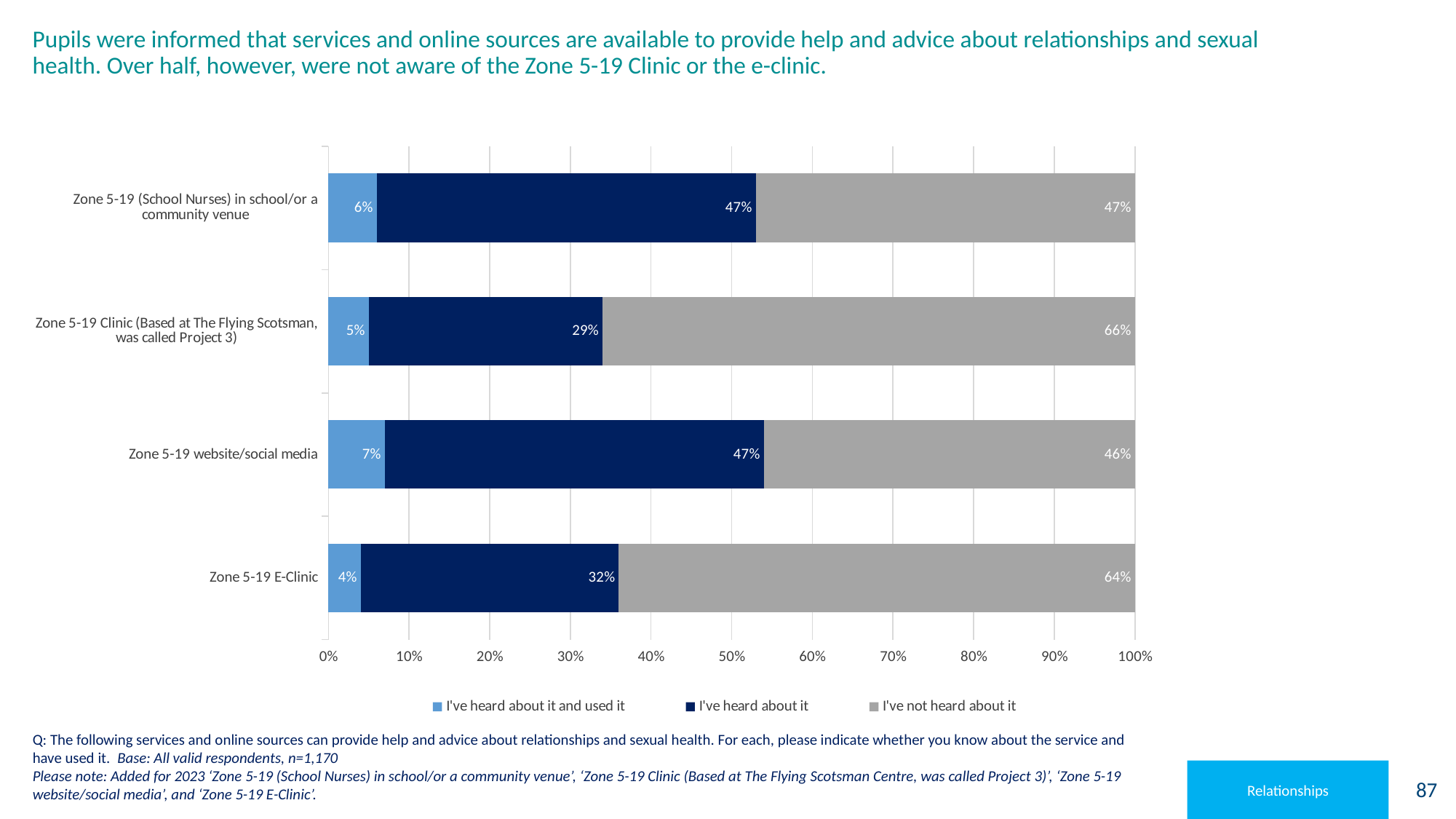
Which service has the highest percentage of pupils who have not heard about it? Zone 5-19 Clinic (Based at The Flying Scotsman, was called Project 3) What type of chart is shown on the slide? Stacked bar chart Which has a larger 'I've heard about it' percentage: Zone 5-19 (School Nurses) in school/or a community venue or Zone 5-19 E-Clinic? Zone 5-19 (School Nurses) in school/or a community venue What percentage of pupils said they had heard about and used the Zone 5-19 website/social media? 7% Which service has the lowest percentage of pupils who have heard about it and used it? Zone 5-19 E-Clinic How many series does the legend list? 3 Which colour represents 'I've not heard about it' in the chart? Grey How many services are shown on the chart? 4 What is the combined percentage of pupils who have heard about the Zone 5-19 Clinic (Based at The Flying Scotsman, was called Project 3), whether or not they used it? 34% What is the difference between the 'I've not heard about it' percentages for the Zone 5-19 E-Clinic and the Zone 5-19 website/social media? 18 percentage points What percentage of pupils said they had heard about the Zone 5-19 E-Clinic (but not used it)? 32% What percentage of pupils said they had not heard about the Zone 5-19 Clinic (Based at The Flying Scotsman, was called Project 3)? 66%